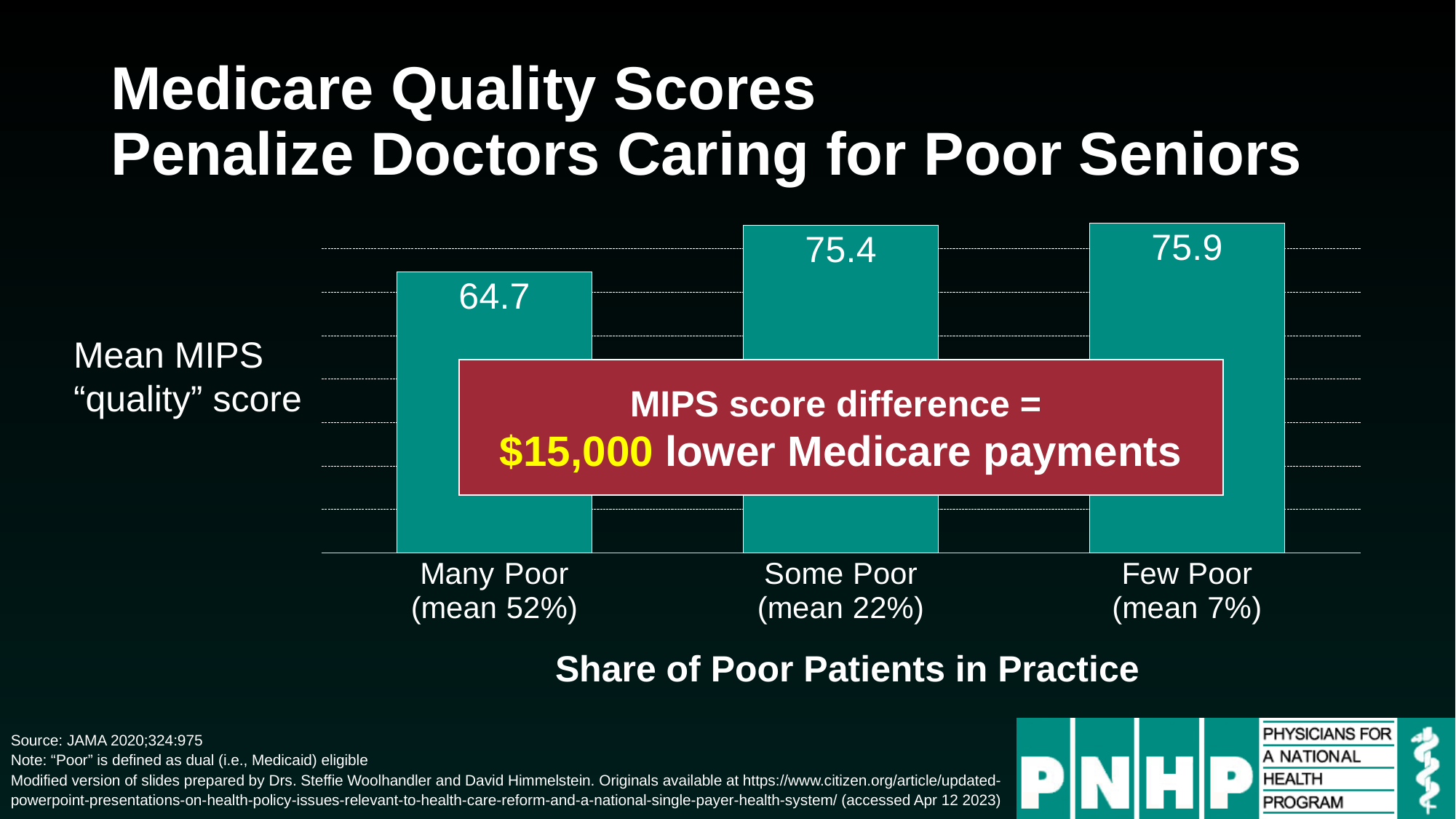
What is the mean MIPS quality score for practices with Many Poor patients (mean 52%)? 64.7 What kind of chart is shown on the slide? Bar chart What is the x-axis title of the chart? Share of Poor Patients in Practice What is the difference in mean MIPS quality score between Few Poor and Many Poor practices? 11.2 How many categories are shown on the x axis of the chart? 3 What is the mean MIPS quality score for practices with Few Poor patients (mean 7%)? 75.9 Which category has the highest mean MIPS quality score? Few Poor (mean 7%) Which category has the lowest mean MIPS quality score? Many Poor (mean 52%) What is the difference in mean MIPS quality score between Some Poor and Many Poor practices? 10.7 What is the mean MIPS quality score for practices with Some Poor patients (mean 22%)? 75.4 Do the mean MIPS quality scores rise or fall moving from Many Poor to Few Poor along the x axis? Rise Which has a higher mean MIPS quality score, Many Poor or Some Poor practices? Some Poor